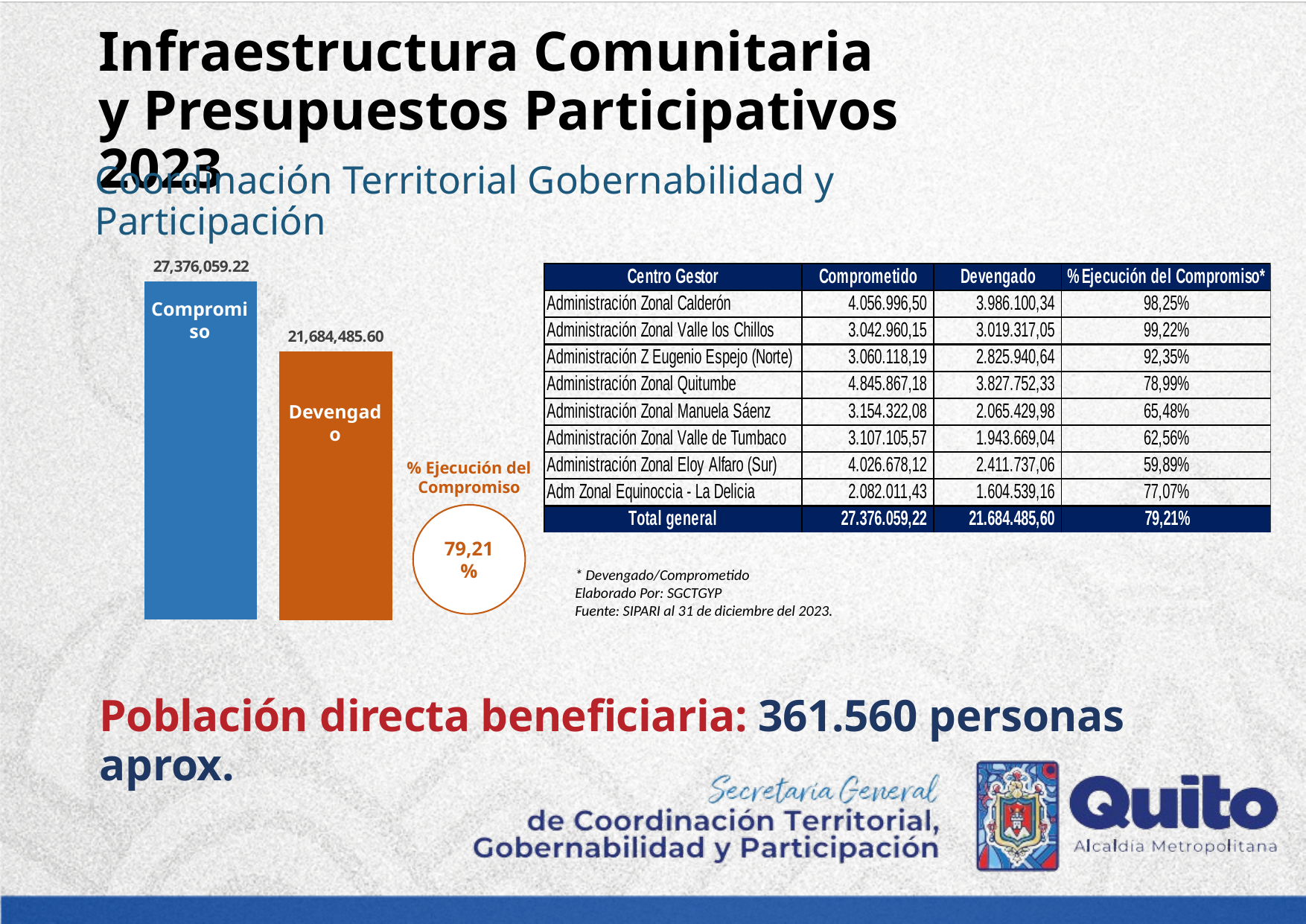
What is the value shown for the Compromiso bar? 27,376,059.22 What percentage is shown in the circle labelled % Ejecución del Compromiso? 79,21% What colour is the Devengado bar? Orange What is the value shown for the Devengado bar? 21,684,485.60 How many bars are plotted in the chart? 2 What is the difference between the Compromiso and Devengado values? 5,691,573.62 Which category has the lowest value in the bar chart? Devengado What colour is the Compromiso bar? Blue Which bar is taller, Compromiso or Devengado? Compromiso What kind of chart is shown on the left of the slide? Bar chart Which category has the highest value in the bar chart? Compromiso